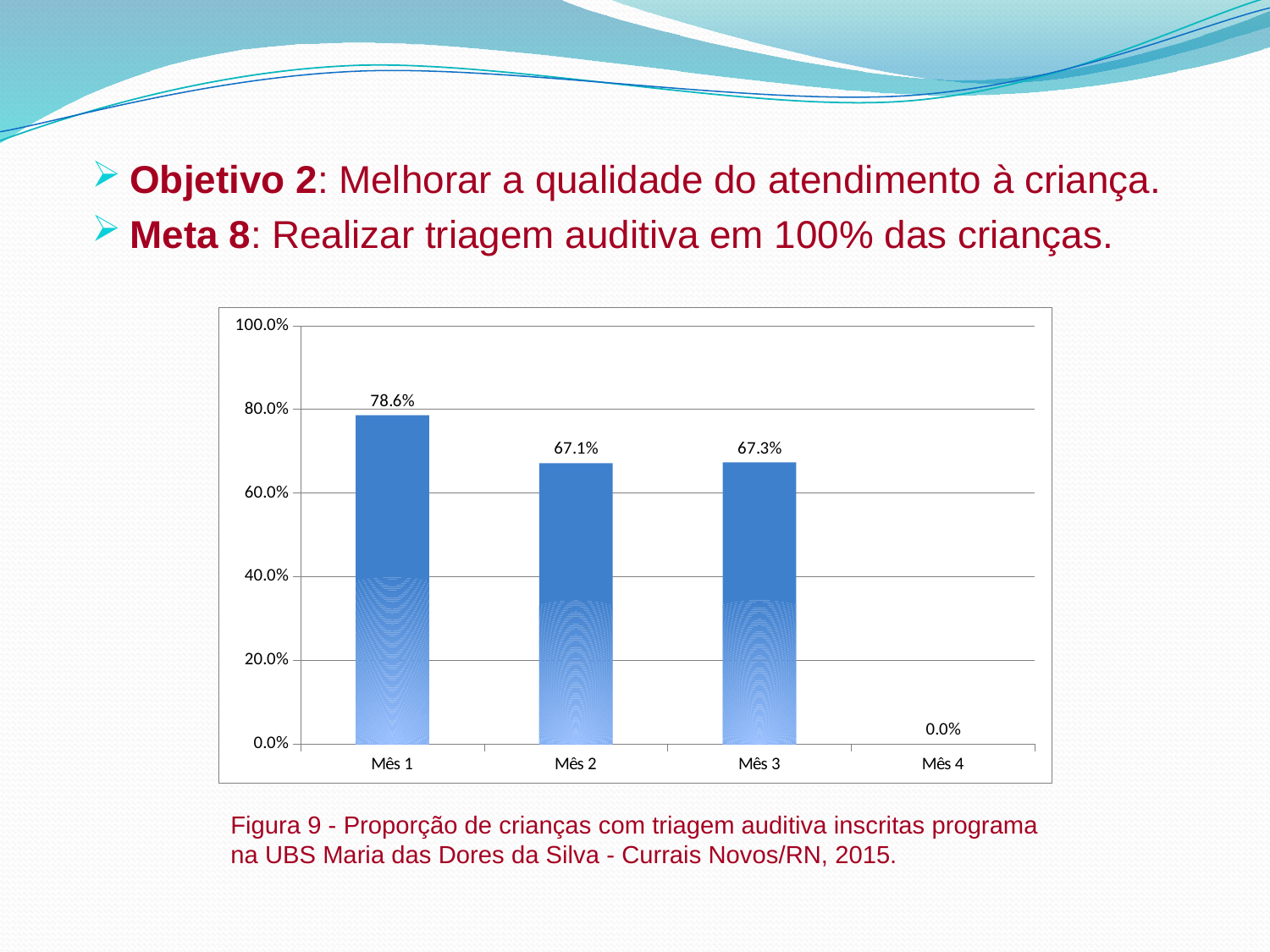
What is the difference between the values for Mês 1 and Mês 2? 11.5% What is the value for Mês 2? 67.1% Which month has the lowest value? Mês 4 Which month has the highest value? Mês 1 What is the value for Mês 1? 78.6% How many months are shown on the x axis? 4 What is the difference between the values for Mês 3 and Mês 2? 0.2% What is the value for Mês 3? 67.3% Which is larger, the value for Mês 1 or the value for Mês 3? Mês 1 Is the value for Mês 2 greater or less than 80.0%? less What kind of chart is shown on the slide? bar chart What is the value for Mês 4? 0.0%